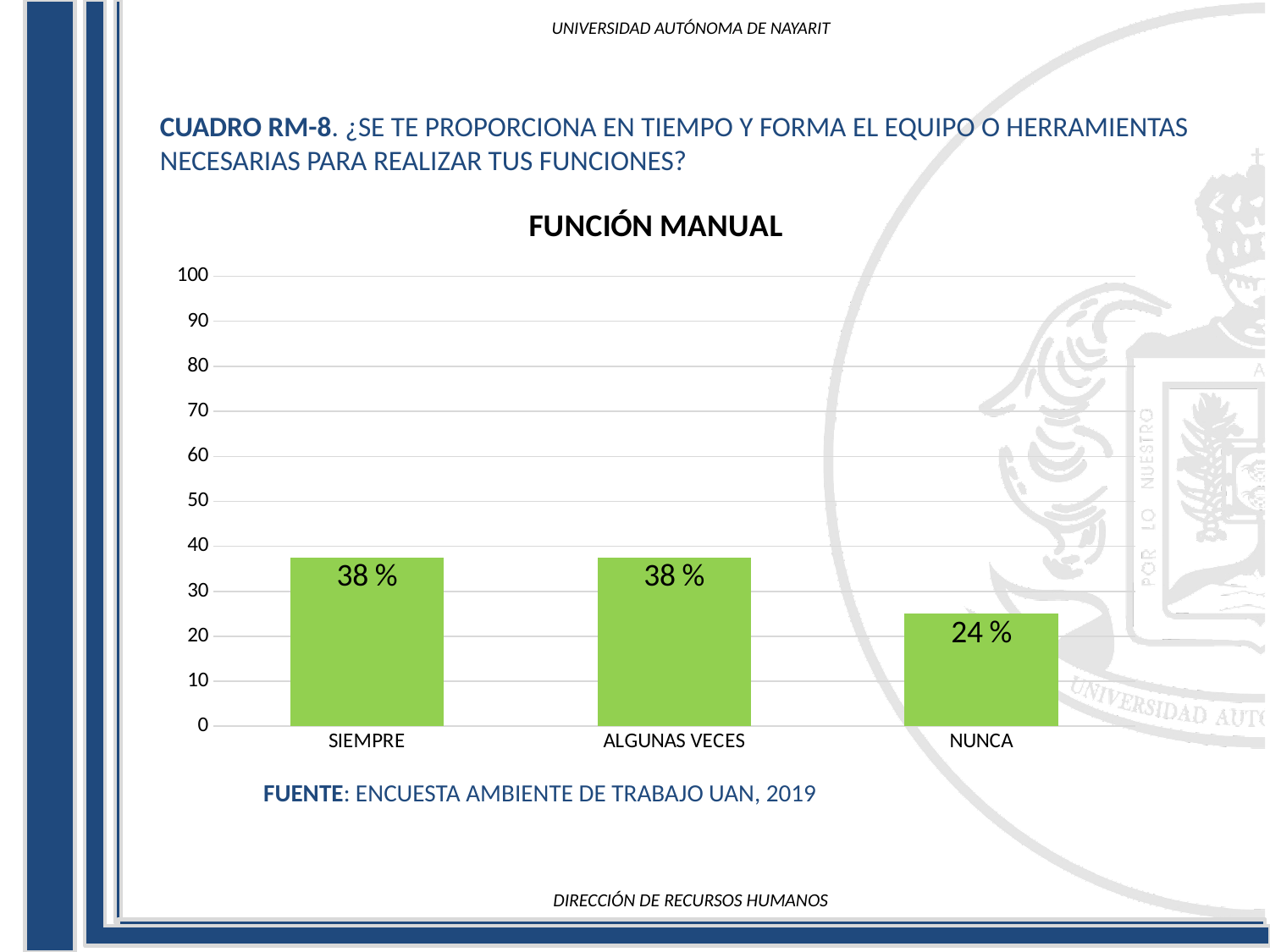
Which is larger, the value for ALGUNAS VECES or the value for NUNCA? ALGUNAS VECES What is the value for NUNCA? 24 % Is the value for SIEMPRE greater or less than 30? greater Which category has the lowest value? NUNCA What kind of chart is shown? bar chart What is the highest value shown on the y axis? 100 Is the value for NUNCA greater or less than 30? less What is the value for ALGUNAS VECES? 38 % What is the difference between the values for SIEMPRE and NUNCA? 14 % What is the title of the chart? FUNCIÓN MANUAL What is the value for SIEMPRE? 38 % How many categories are shown on the x axis? 3